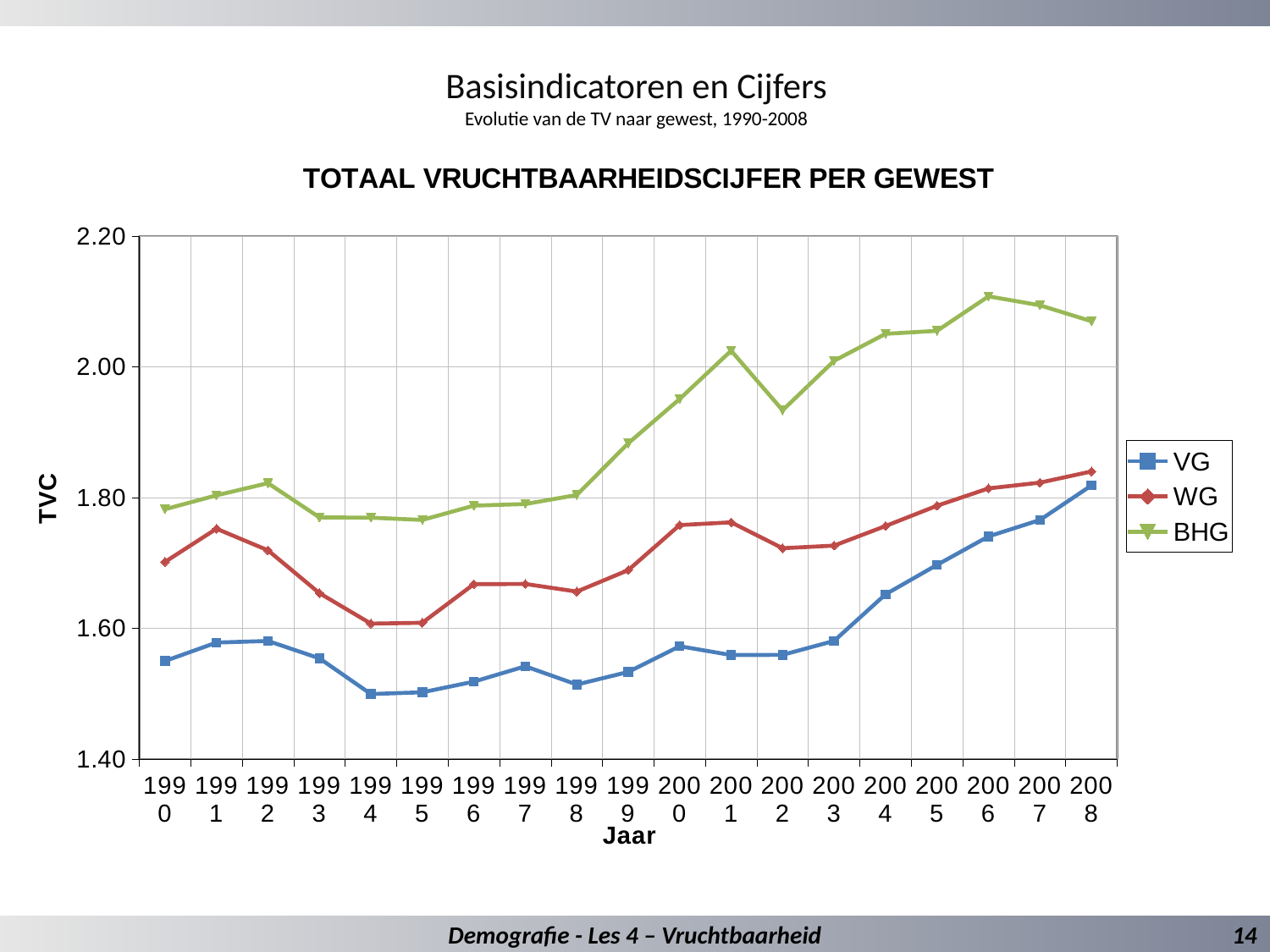
How many years are plotted along the x axis? 19 What kind of chart is shown on the slide? line chart Which is larger for BHG: the value in 2001 or the value in 2002? 2001 Does the VG series rise or fall between 2003 and 2008? rise In which year does the VG series reach its highest value? 2008 Which series has the highest values across all years? BHG Is the VG value for 1994 greater or less than 1.60? less What is the title of the chart? TOTAAL VRUCHTBAARHEIDSCIJFER PER GEWEST Which series has the lowest values across all years? VG Is the BHG value for 2002 greater or less than 2.00? less Is the BHG value for 2006 greater or less than 2.00? greater How many series does the legend list? 3